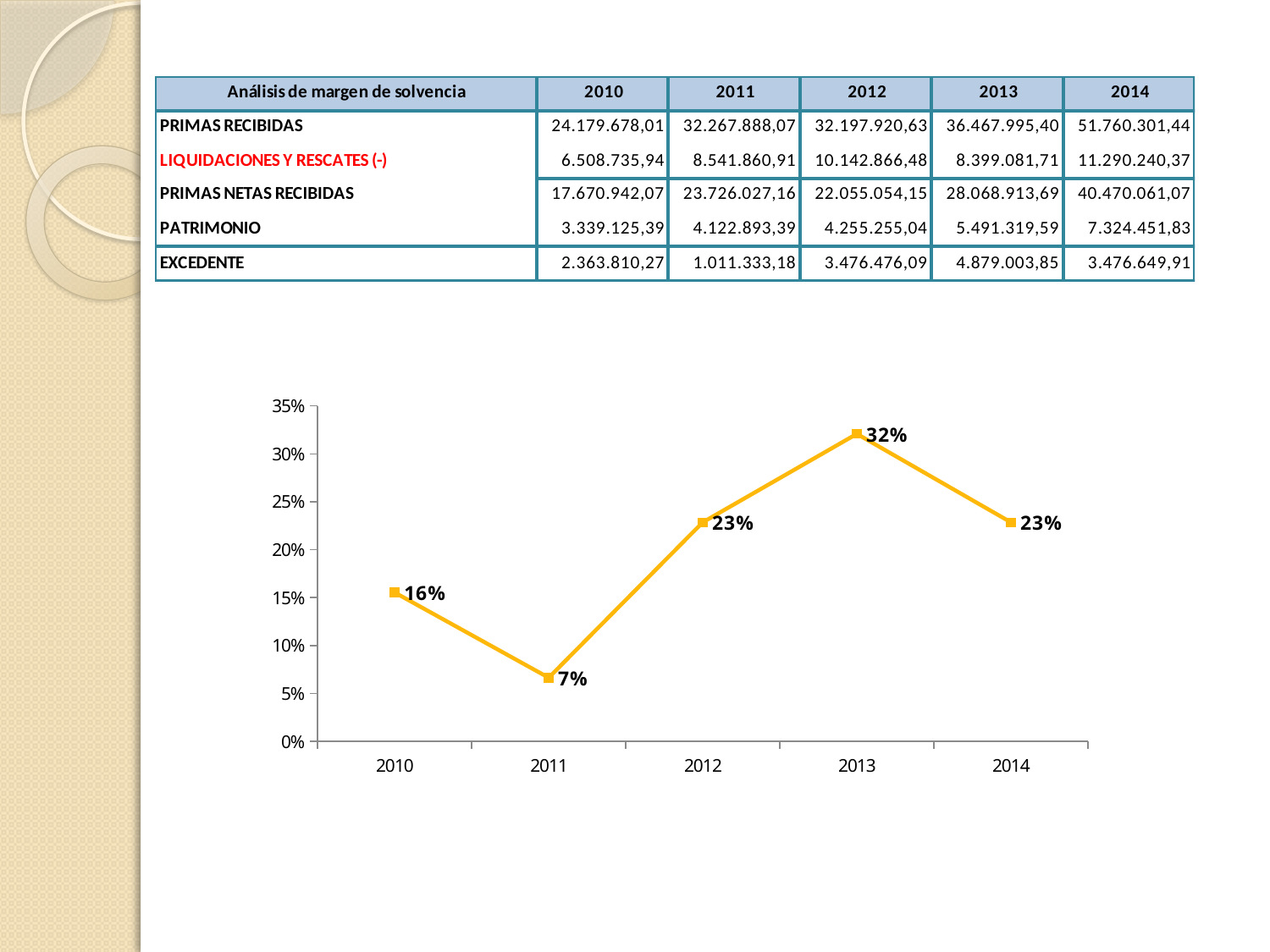
What kind of chart is shown on the slide? line chart What is the highest tick value shown on the y axis of the line chart? 35% What is the value plotted for 2011 in the line chart? 7% What is the value plotted for 2010 in the line chart? 16% Does the value in the line chart rise or fall from 2011 to 2013? rise How many data points are plotted in the line chart? 5 Which year has the lowest value in the line chart? 2011 Which is larger in the line chart, the value for 2010 or the value for 2012? 2012 What is the value plotted for 2013 in the line chart? 32% Which year has the highest value in the line chart? 2013 Is the value for 2013 in the line chart greater or less than 30%? greater What is the difference between the values for 2013 and 2011 in the line chart? 25%